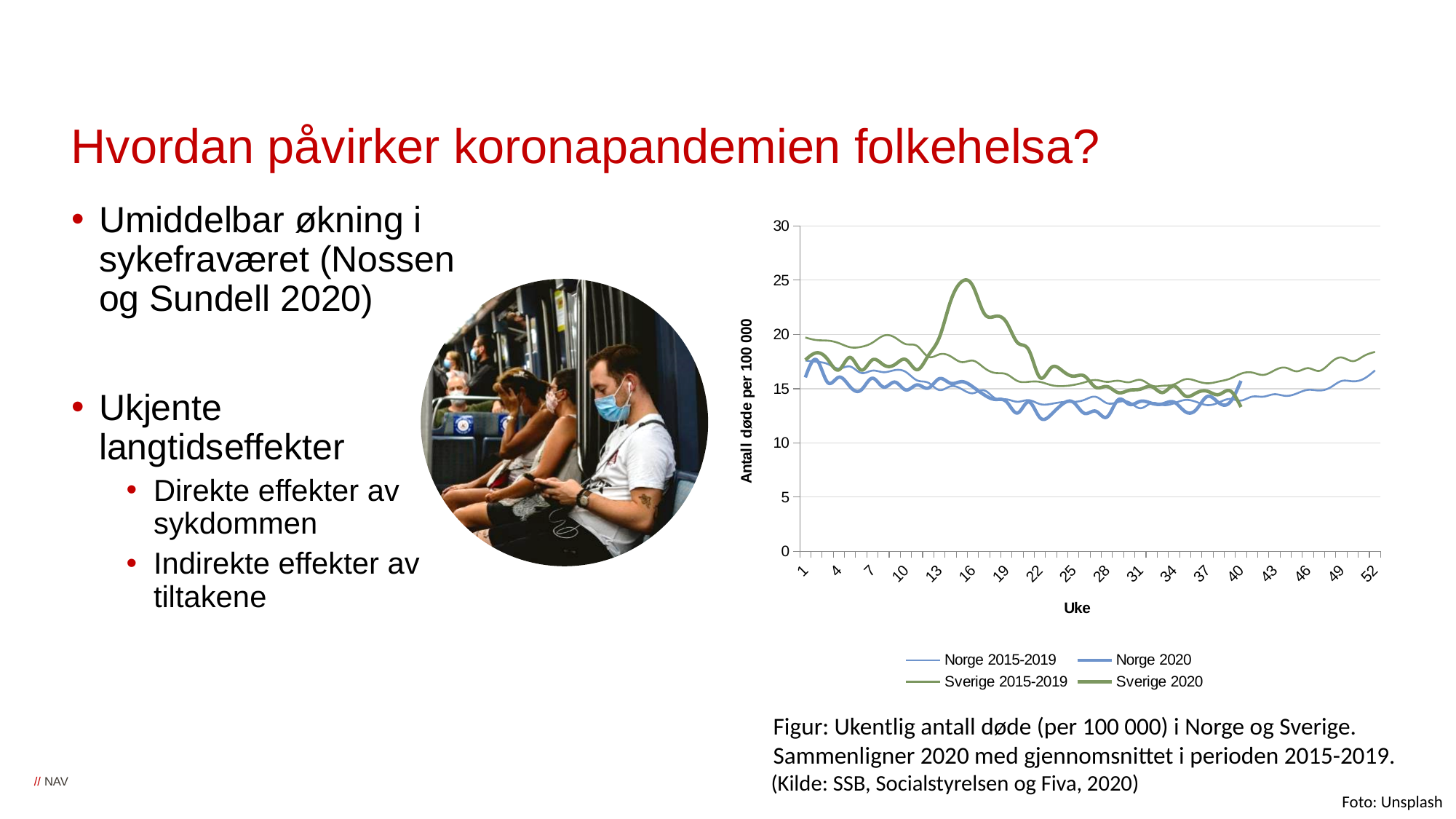
Which series reaches the highest peak in the chart? Sverige 2020 What kind of chart is shown on the slide? line chart Is the value for Norge 2020 at week 22 greater or less than 15? less What is the title of the chart's horizontal axis? Uke Is the value for Norge 2015-2019 at week 1 greater or less than 20? less At week 16, which series has the higher value: Sverige 2020 or Norge 2020? Sverige 2020 Is the value for Sverige 2020 at week 16 greater or less than 20? greater How many series does the chart legend list? 4 Does the Norge 2015-2019 line rise or fall between week 40 and week 52? rise What is the title of the chart's vertical axis? Antall døde per 100 000 Does the Sverige 2020 line rise or fall between week 16 and week 22? fall